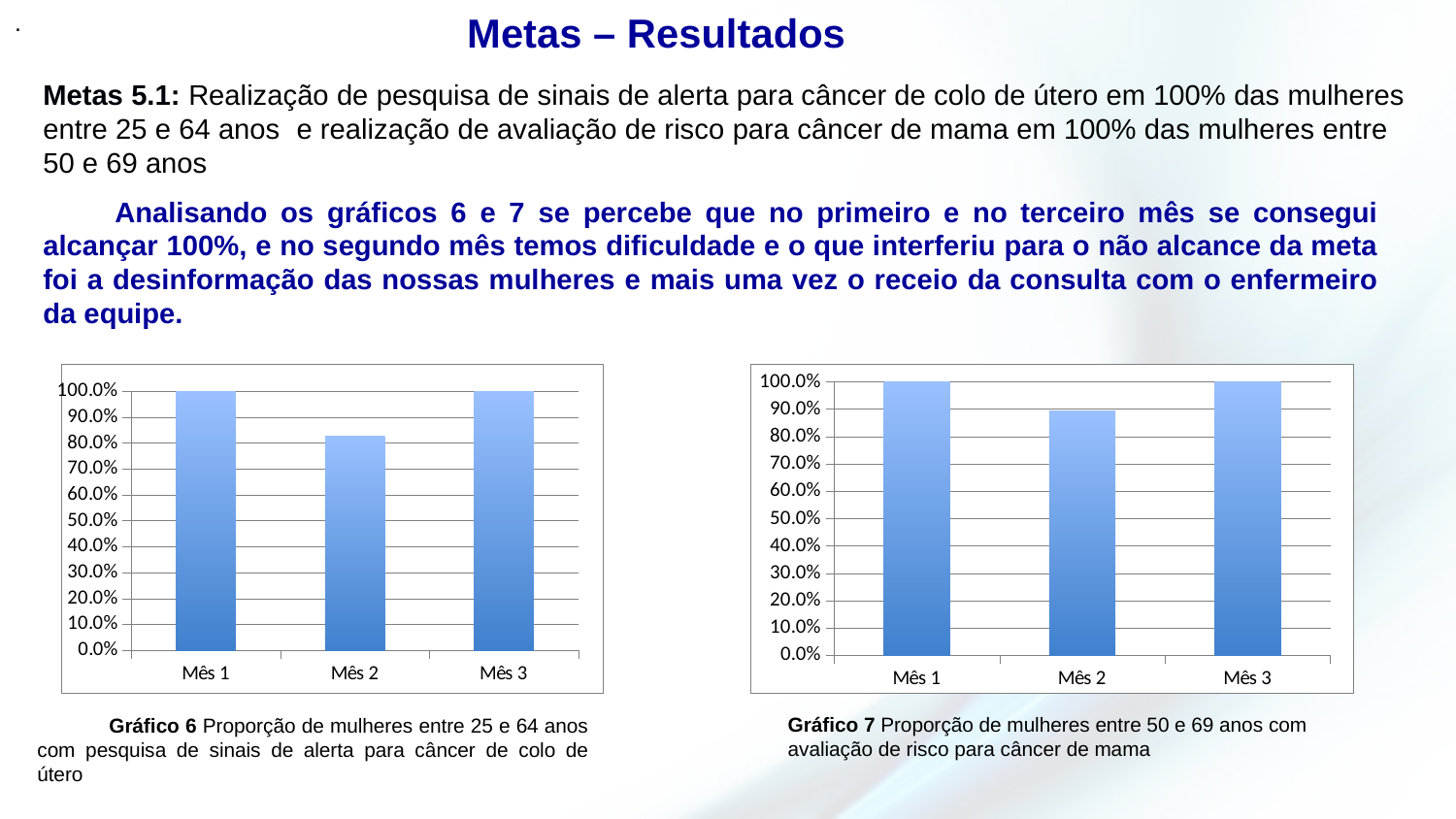
In the right chart (Gráfico 7), is the value for Mês 2 greater or less than 80.0%? greater What is the highest value shown on the y axis of the left chart (Gráfico 6)? 100.0% What kind of chart is the left chart (Gráfico 6)? bar chart How many categories are shown on the x axis of the right chart (Gráfico 7)? 3 What is the caption label of the right chart? Gráfico 7 Proporção de mulheres entre 50 e 69 anos com avaliação de risco para câncer de mama In the left chart (Gráfico 6), what is the value for Mês 1? 100.0% In the left chart (Gráfico 6), is the value for Mês 2 greater or less than 90.0%? less In the right chart (Gráfico 7), which month has the lowest value? Mês 2 In the left chart (Gráfico 6), which month has the lowest value? Mês 2 In the right chart (Gráfico 7), what is the value for Mês 3? 100.0% In the right chart (Gráfico 7), which is larger, the value for Mês 1 or the value for Mês 2? Mês 1 In the left chart (Gráfico 6), is the value for Mês 2 greater or less than 80.0%? greater